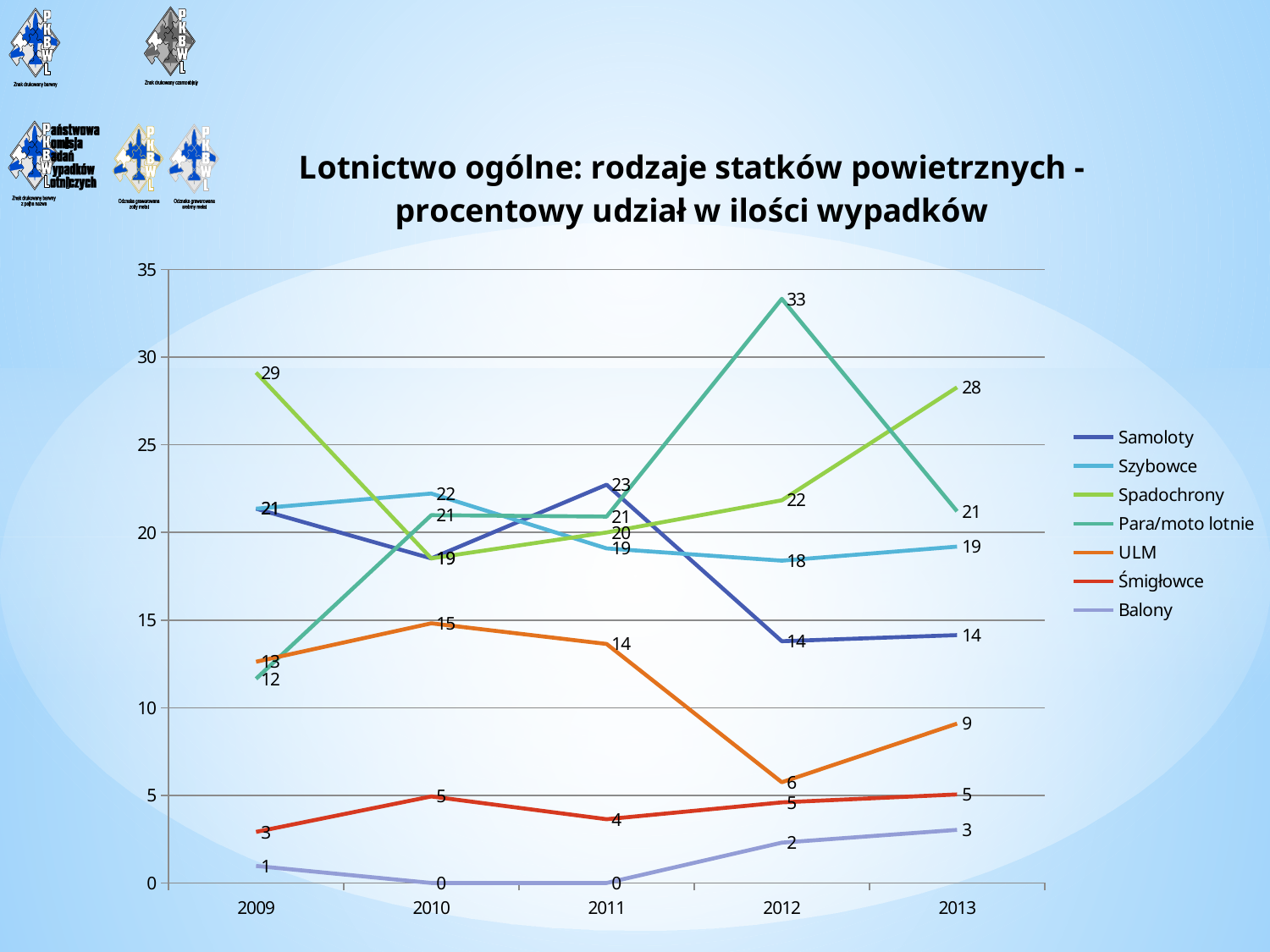
How many years are shown on the x axis? 5 What is the value for Śmigłowce in 2011? 4 What is the value for Balony in 2010? 0 Which is larger in 2013, Spadochrony or Szybowce? Spadochrony What is the value for Spadochrony in 2013? 28 What kind of chart is shown on the slide? line chart What is the difference between the ULM values in 2010 and 2012? 9 What is the value for Para/moto lotnie in 2012? 33 In which year does Para/moto lotnie reach its highest value? 2012 How many series does the legend list? 7 In which year does ULM have its lowest value? 2012 Does the ULM series rise or fall from 2010 to 2012? fall